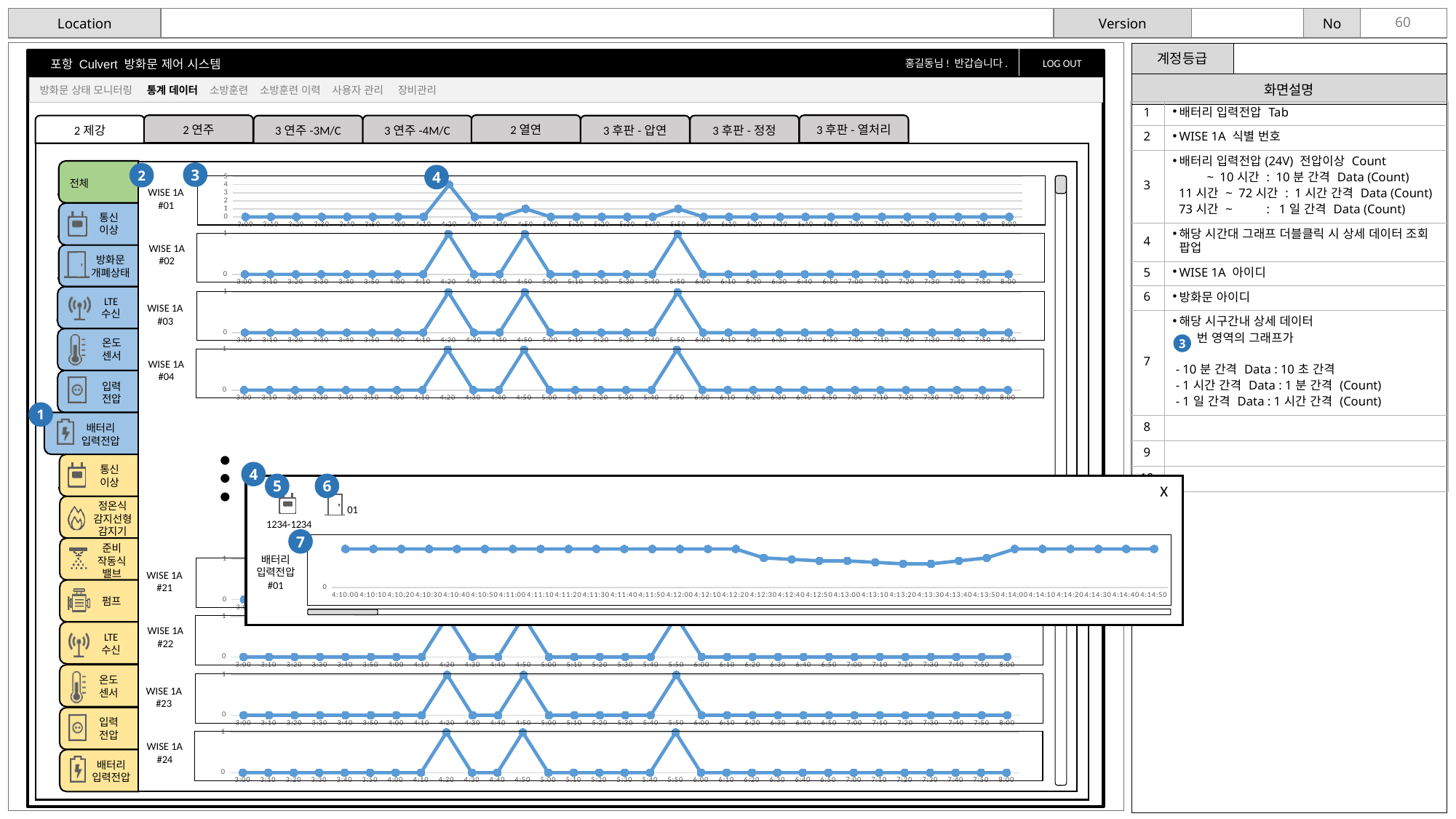
In the WISE 1A #23 chart, which is larger, the value at 4:50 or the value at 5:00? 4:50 In the WISE 1A #02 chart, what is the value at 4:20? 1 In the popup chart labelled 배터리 입력전압 #01, does the line fall or rise between 4:12:10 and 4:12:30? fall In the WISE 1A #04 chart, what is the value at 5:50? 1 In the WISE 1A #01 chart, is the value at 4:50 greater or less than 3? less In the WISE 1A #02 chart, what is the difference between the value at 4:20 and the value at 4:30? 1 In the WISE 1A #01 chart, at which time is the value highest? 4:20 What is the first time label on the x axis of the popup chart labelled 배터리 입력전압 #01? 4:10:00 In the WISE 1A #03 chart, what is the value at 3:00? 0 What kind of chart is the WISE 1A #02 chart? line chart In the WISE 1A #01 chart, is the value at 4:20 greater or less than 3? greater What is the label of the topmost chart in the main chart area? WISE 1A #01